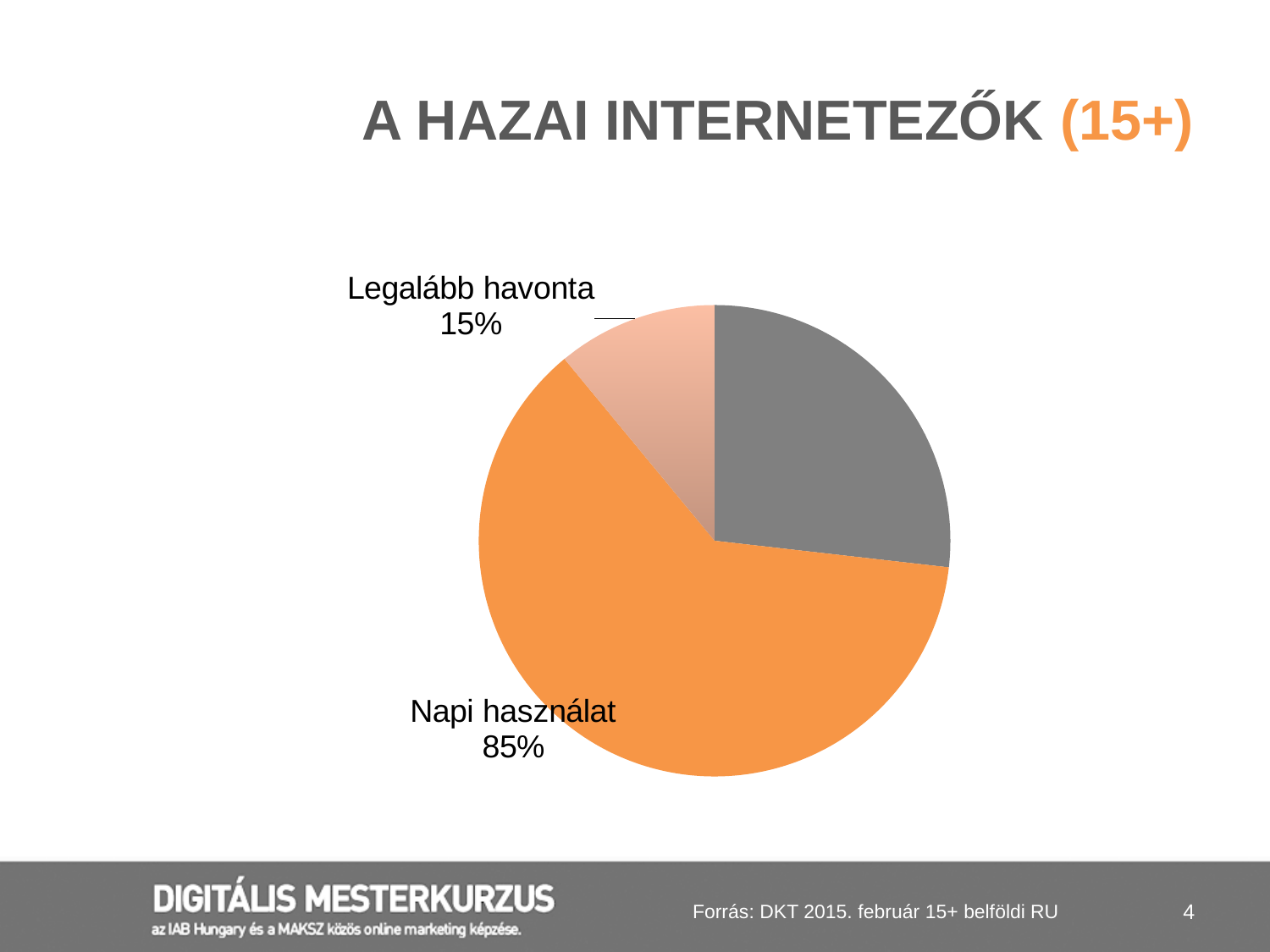
What value is shown for the "Legalább havonta" slice? 15% Which labelled slice has the largest value? Napi használat What is the difference between the values shown for "Napi használat" and "Legalább havonta"? 70% What kind of chart is shown on the slide? pie chart What colour is the "Napi használat" slice of the pie chart? orange Is the value shown for "Legalább havonta" greater or less than 20%? less Is the value shown for "Napi használat" greater or less than 50%? greater Which labelled slice has the smaller value? Legalább havonta Which labelled slice has the larger value, "Napi használat" or "Legalább havonta"? Napi használat What is the title of the slide containing the pie chart? A HAZAI INTERNETEZŐK (15+) What value is shown for the "Napi használat" slice? 85%